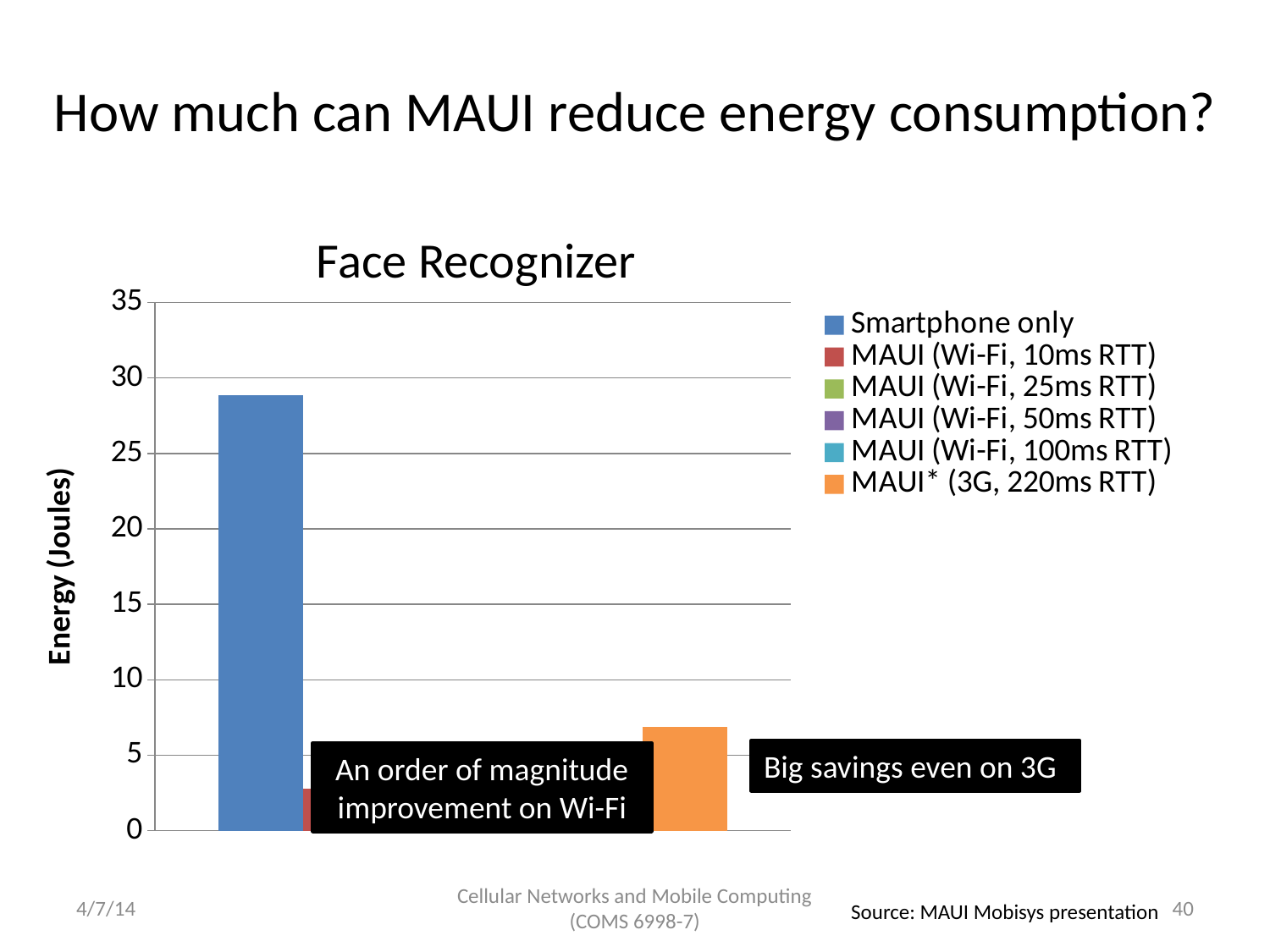
Which series has the highest energy consumption? Smartphone only Is the value for MAUI* (3G, 220ms RTT) greater or less than 5? greater Is the value for MAUI* (3G, 220ms RTT) greater or less than 10? less How many series does the legend list? 6 What is the label of the vertical axis? Energy (Joules) What type of chart is shown on the slide? bar chart What is the title of the chart? Face Recognizer Which is larger, the value for Smartphone only or the value for MAUI* (3G, 220ms RTT)? Smartphone only Which is larger, the value for MAUI* (3G, 220ms RTT) or the value for MAUI (Wi-Fi, 10ms RTT)? MAUI* (3G, 220ms RTT) Is the value for MAUI (Wi-Fi, 10ms RTT) greater or less than 5? less